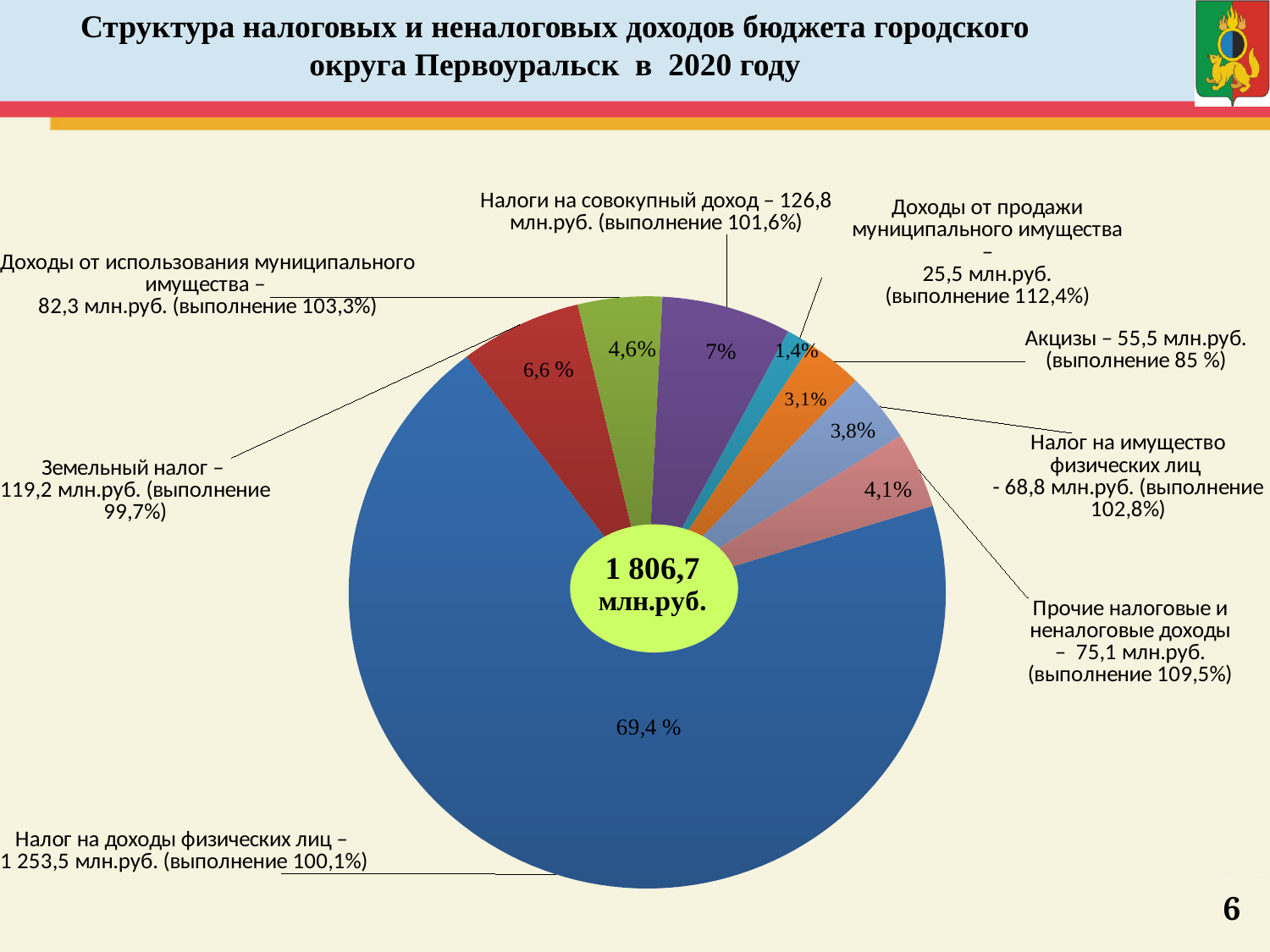
How many slices does the pie chart have? 8 What kind of chart is shown on the slide? pie chart Which category has the smallest share of the pie? Доходы от продажи муниципального имущества What share of the pie does Налог на доходы физических лиц have? 69,4 % Which has a larger share of the pie: Налог на имущество физических лиц or Акцизы? Налог на имущество физических лиц Which category has the largest share of the pie? Налог на доходы физических лиц What is the amount shown for Акцизы? 55,5 млн.руб. What is the difference in percentage points between the share of Налоги на совокупный доход (7%) and Доходы от использования муниципального имущества (4,6%)? 2,4 What execution percentage is shown for Доходы от продажи муниципального имущества? 112,4% What is the amount shown for Налоги на совокупный доход? 126,8 млн.руб. What total amount is shown in the centre of the pie chart? 1 806,7 млн.руб. What share of the pie does Земельный налог have? 6,6 %